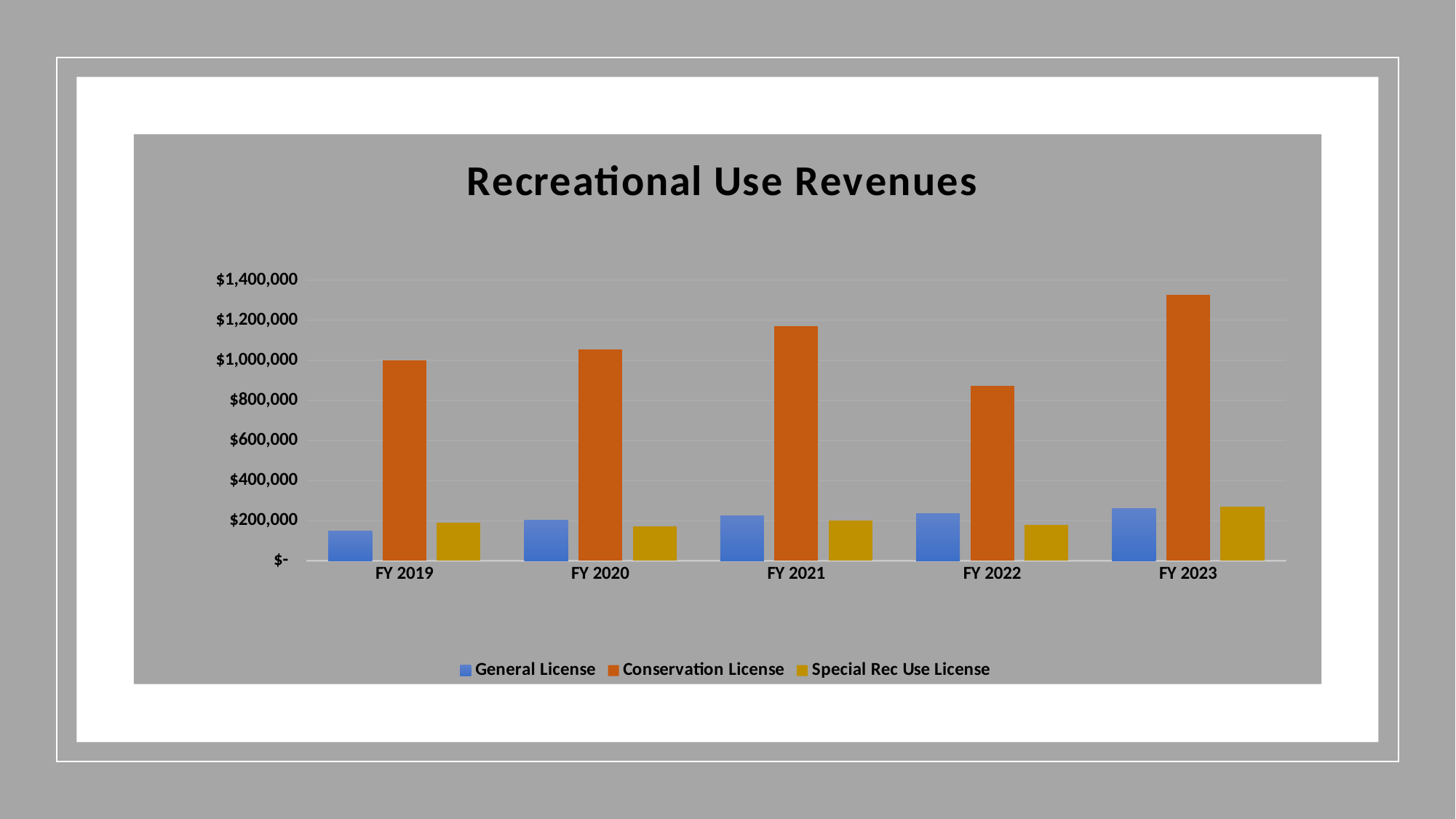
How many series does the legend list? 3 Is the Conservation License value for FY 2022 greater or less than $1,000,000? less Is the General License value for FY 2019 greater or less than $200,000? less Is the Conservation License value for FY 2023 greater or less than $1,200,000? greater Does the General License revenue rise or fall from FY 2019 to FY 2023? Rises In which fiscal year is the Conservation License revenue highest? FY 2023 How many fiscal years are shown on the x axis? 5 In which fiscal year is the Conservation License revenue lowest? FY 2022 What is the title of the chart? Recreational Use Revenues Which is larger: the Conservation License revenue in FY 2021 or in FY 2020? FY 2021 In which fiscal year is the General License revenue lowest? FY 2019 What type of chart is shown on the slide? Bar chart